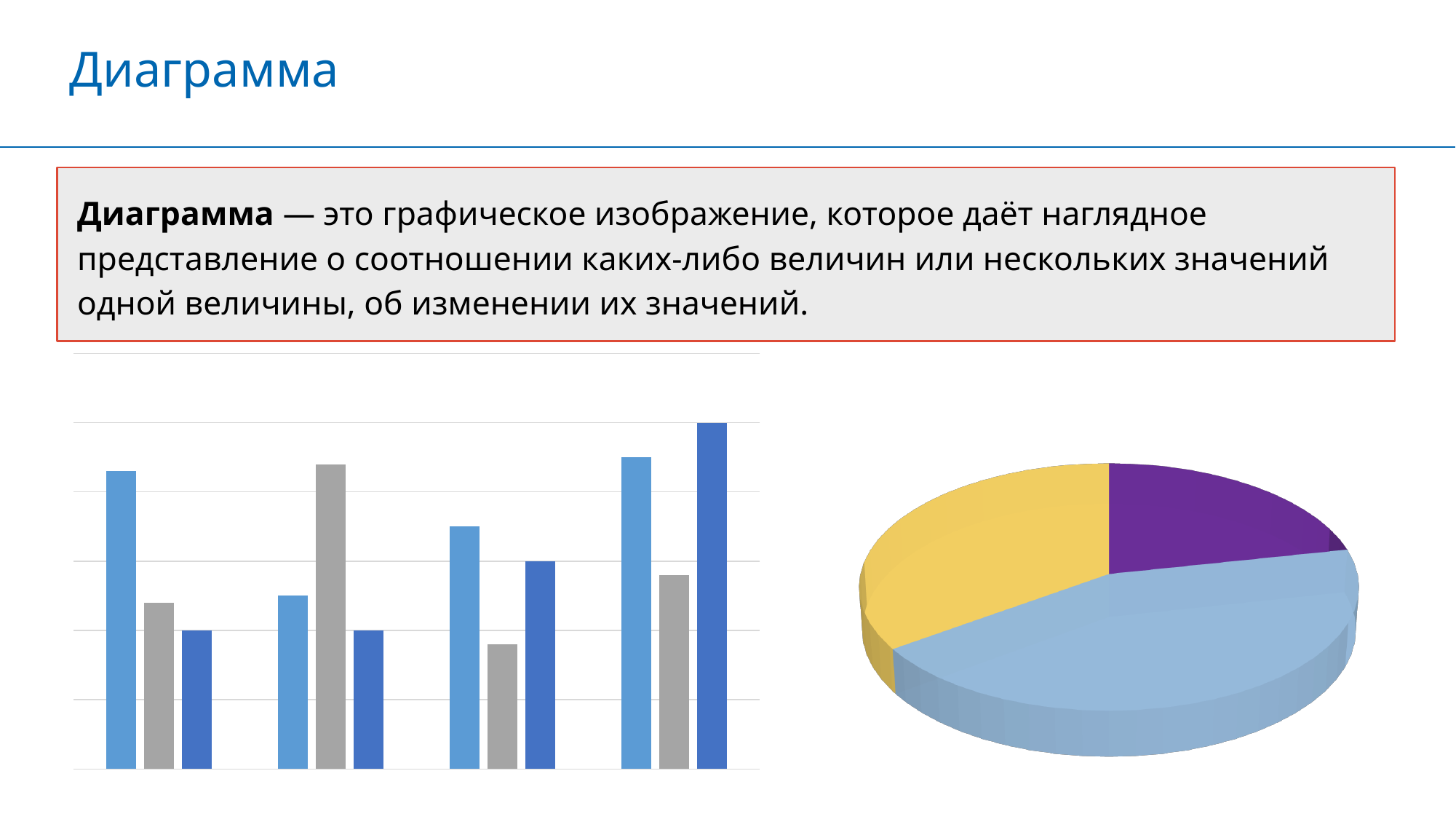
What kind of chart is the chart on the left side of the slide? bar chart In the pie chart on the right, which slice is the largest? the light blue slice In the bar chart on the left, how many bars are in each group? 3 In the bar chart on the left, how many groups of bars are there? 4 In the bar chart on the left, is the light blue bar in the first group taller or shorter than the light blue bar in the second group? taller What kind of chart is the chart on the right side of the slide? pie chart In the pie chart on the right, which slice is the smallest? the purple slice In the bar chart on the left, do the dark blue bars rise or fall from the first group to the fourth group? rise In the bar chart on the left, which bar is the shortest? the gray bar in the third group In the pie chart on the right, how many slices are there? 3 In the bar chart on the left, which bar is the tallest? the dark blue bar in the fourth group In the pie chart on the right, is the yellow slice larger or smaller than the purple slice? larger